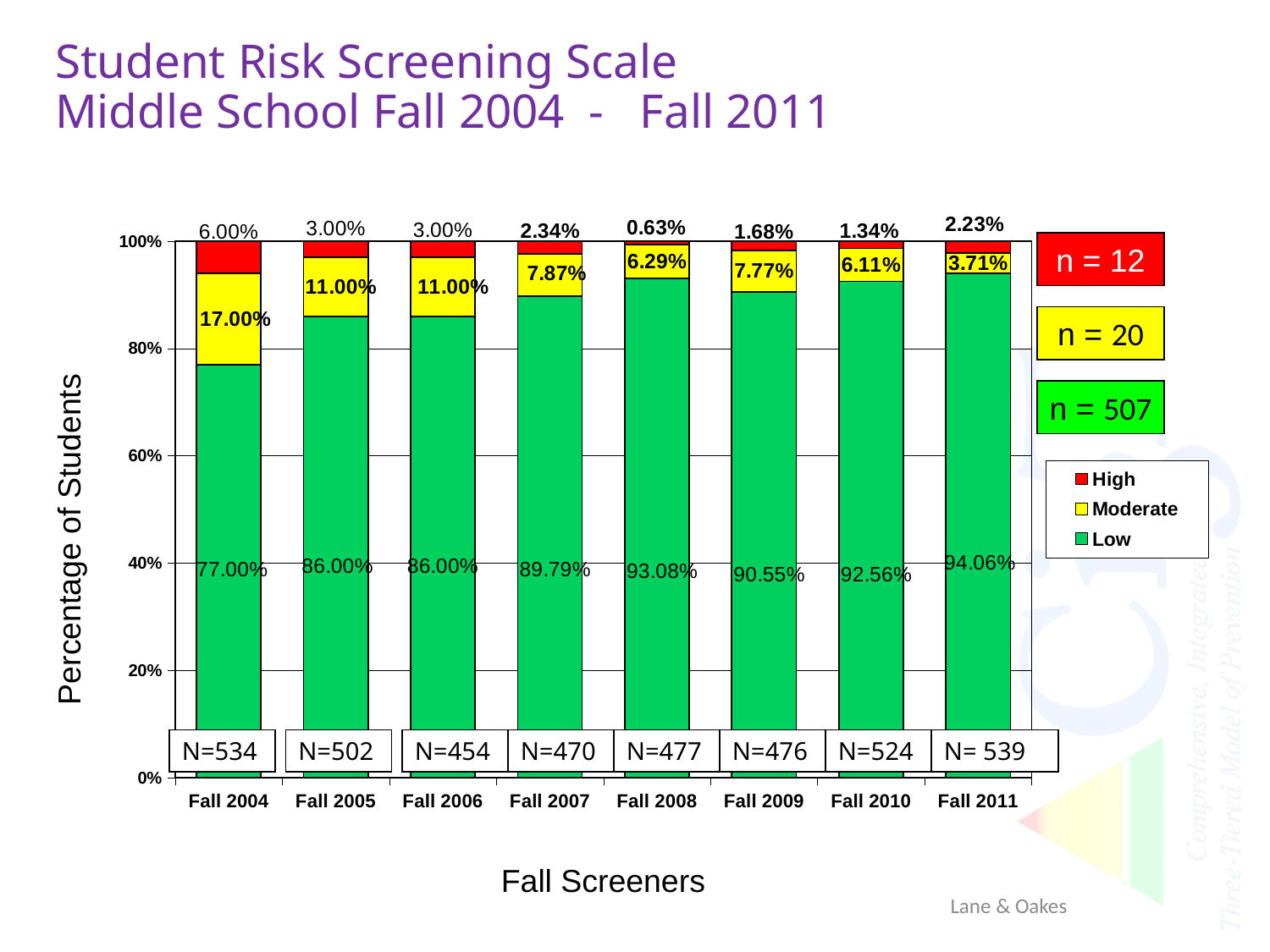
What is the Low percentage for Fall 2007? 89.79% What is the High percentage for Fall 2008? 0.63% Does the Low percentage generally rise or fall from Fall 2004 to Fall 2011? Rise Which has the larger Moderate percentage, Fall 2010 or Fall 2011? Fall 2010 Which fall screener has the highest Low percentage? Fall 2011 How much higher is the Low percentage in Fall 2011 than in Fall 2004? 17.06% Which fall screener has the lowest High percentage? Fall 2008 What is the N value shown for Fall 2006? N=454 How many fall screeners are shown on the x axis? 8 How many series does the legend list? 3 What kind of chart is shown on the slide? Stacked bar chart What is the Moderate percentage for Fall 2009? 7.77%